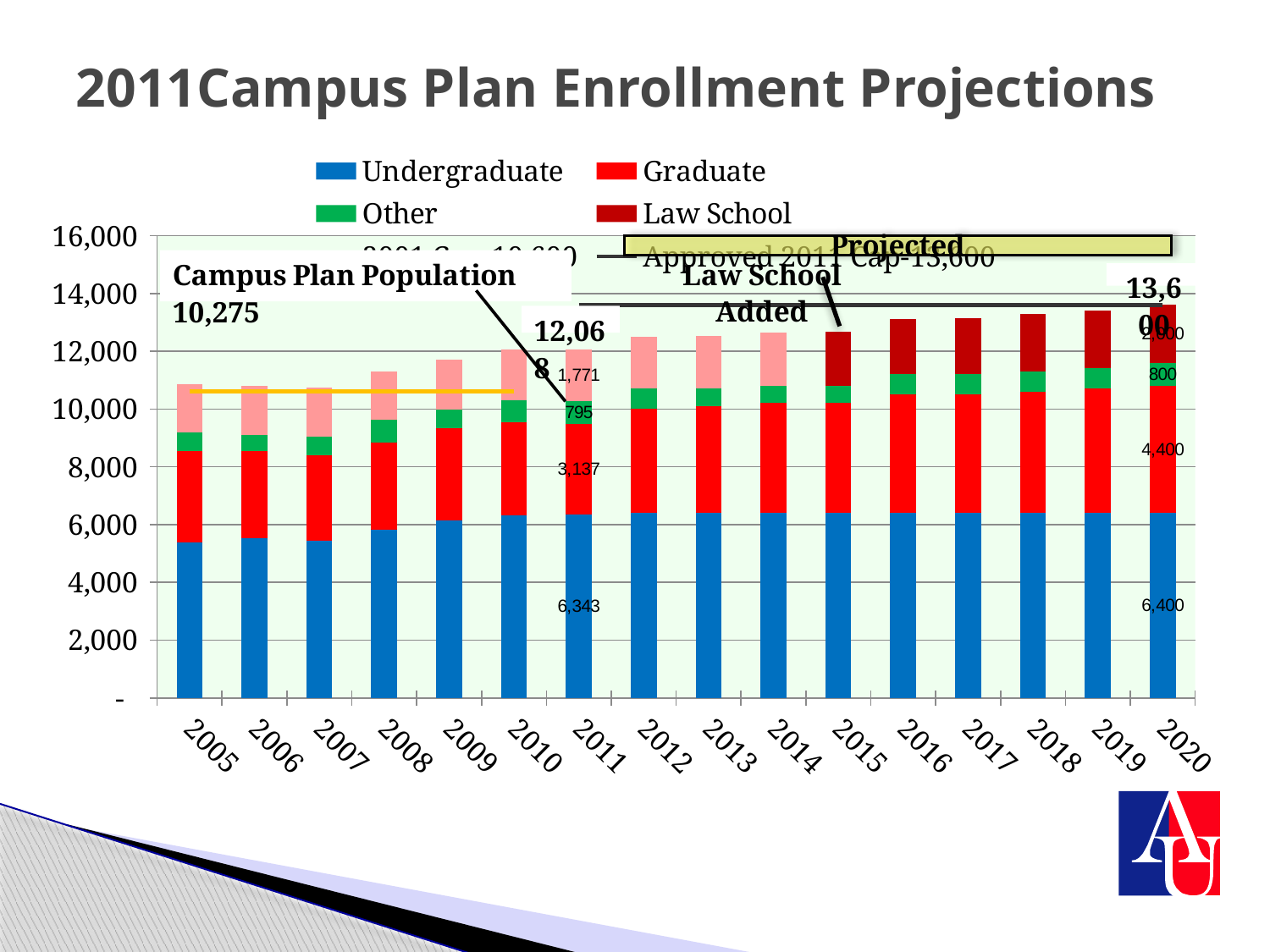
Which is larger, the Graduate value in 2011 or the Graduate value in 2020? 2020 What is the Undergraduate value for 2020? 6,400 Is the Undergraduate value for 2005 greater or less than 6,000? less What is the Graduate value for 2020? 4,400 What is the difference between the Graduate value in 2020 and the Graduate value in 2011? 1,263 What is the title of the slide's chart? 2011Campus Plan Enrollment Projections What kind of chart is shown on the slide? Stacked bar chart What is the Undergraduate value for 2011? 6,343 What is the Graduate value for 2011? 3,137 How many years are shown along the x axis? 16 How many series does the legend list? 4 What is the Other value for 2011? 795